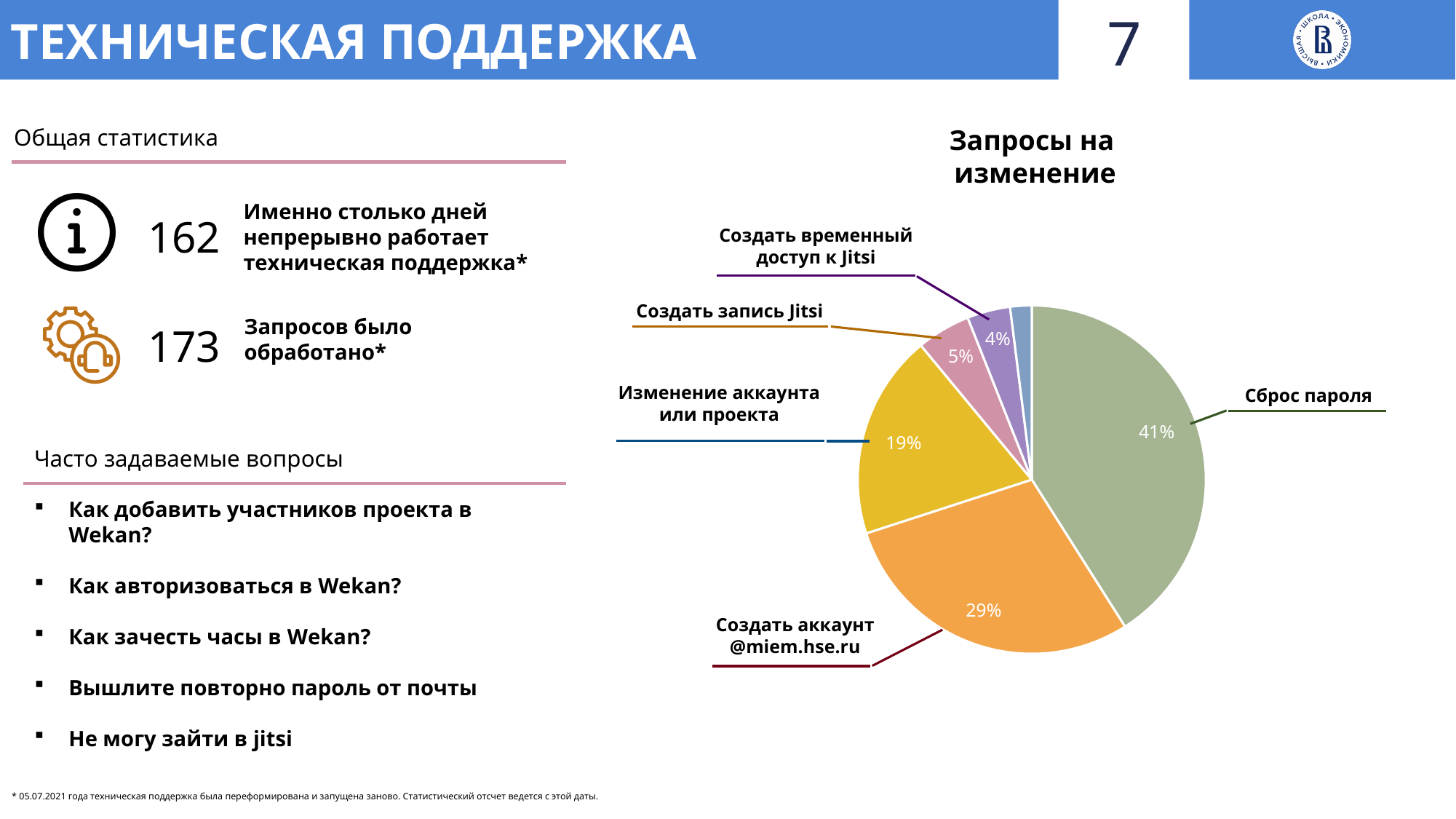
Which labelled category has the smallest percentage shown? Создать временный доступ к Jitsi What percentage is shown for "Создать аккаунт @miem.hse.ru"? 29% What percentage is shown for "Создать временный доступ к Jitsi"? 4% How many slices of the pie have a percentage label printed on them? 5 What is the title of the chart? Запросы на изменение What percentage is shown for "Создать запись Jitsi"? 5% What is the difference in percentage points between "Сброс пароля" and "Создать аккаунт @miem.hse.ru"? 12 Which is larger: the share for "Изменение аккаунта или проекта" or for "Создать запись Jitsi"? Изменение аккаунта или проекта What kind of chart is shown on the slide? pie chart What percentage is shown for "Изменение аккаунта или проекта"? 19% What share of the pie does "Сброс пароля" take? 41% Which category has the largest slice of the pie? Сброс пароля